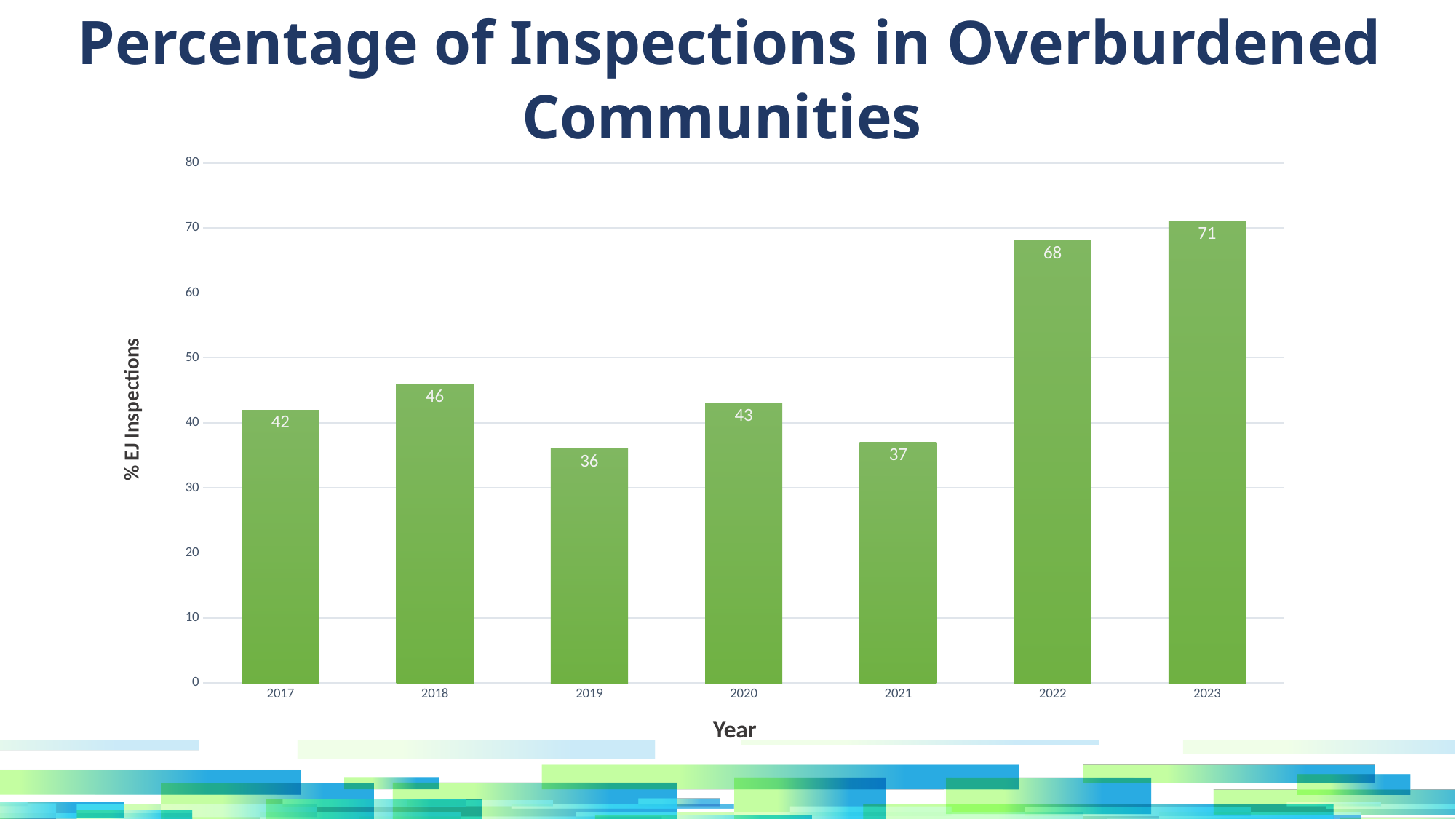
What is the value for 2017? 42 Which year has the highest value? 2023 What is the value for 2021? 37 What is the value for 2023? 71 How many years are shown on the x axis? 7 Is the value for 2022 greater or less than 60? greater What is the label of the y axis? % EJ Inspections What is the difference between the values for 2023 and 2022? 3 What kind of chart is shown on the slide? bar chart What is the difference between the values for 2018 and 2019? 10 Which year has the lowest value? 2019 Which is larger, the value for 2020 or the value for 2021? 2020